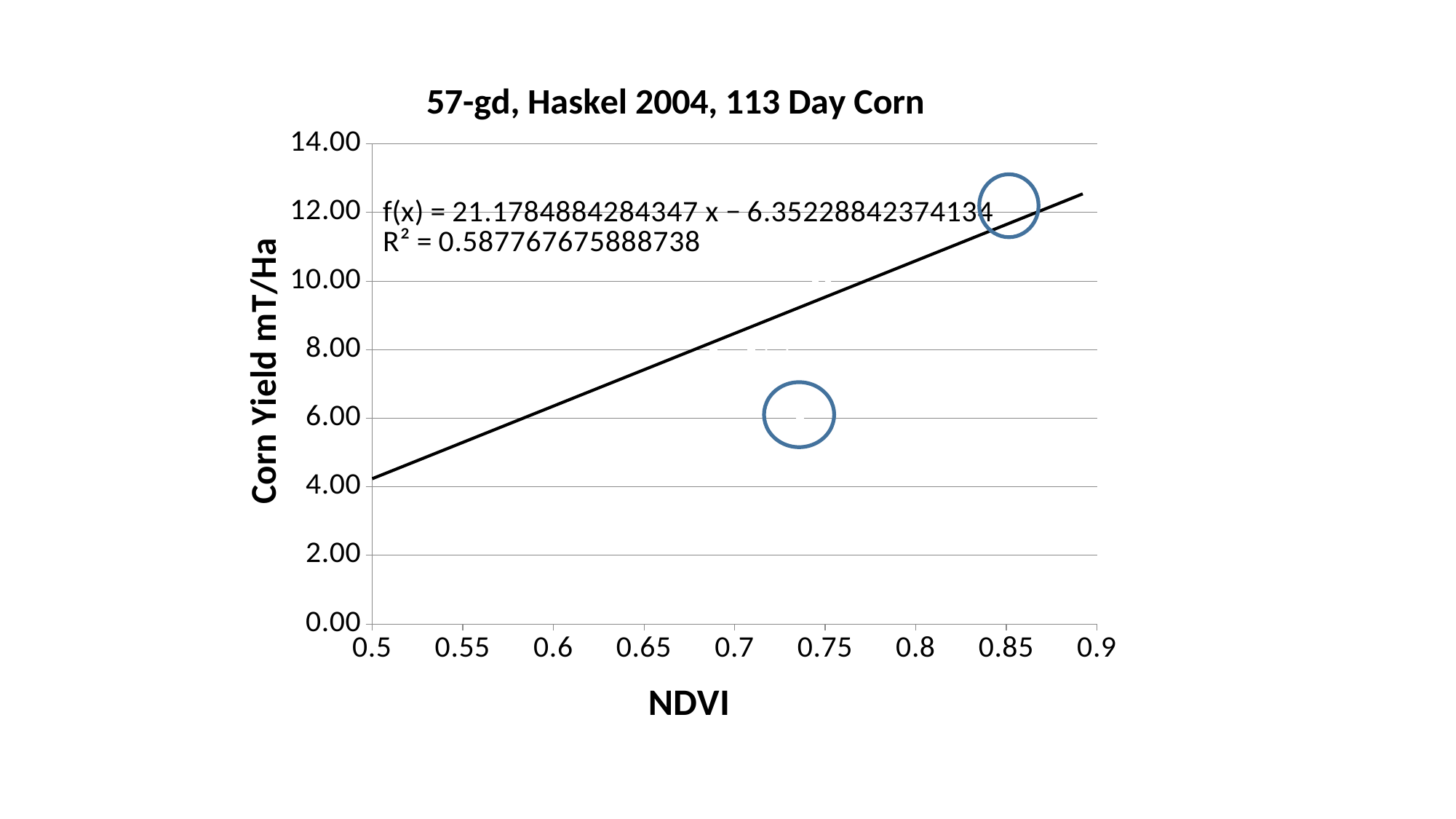
What kind of chart is shown on the slide? scatter chart Does the trendline rise or fall as NDVI increases? rises How many data points are circled on the chart? 2 Is the corn yield of the circled point near NDVI 0.74 greater or less than 8.00 mT/Ha? less What is the title of the chart? 57-gd, Haskel 2004, 113 Day Corn What is the intercept of the trendline equation printed on the chart? −6.35228842374134 Is the trendline value at NDVI 0.5 greater or less than 6.00 mT/Ha? less Is the trendline value at NDVI 0.9 greater or less than 12.00 mT/Ha? greater What is the R² value printed on the chart? 0.587767675888738 What is the label of the x axis? NDVI What is the slope of the trendline equation printed on the chart? 21.1784884284347